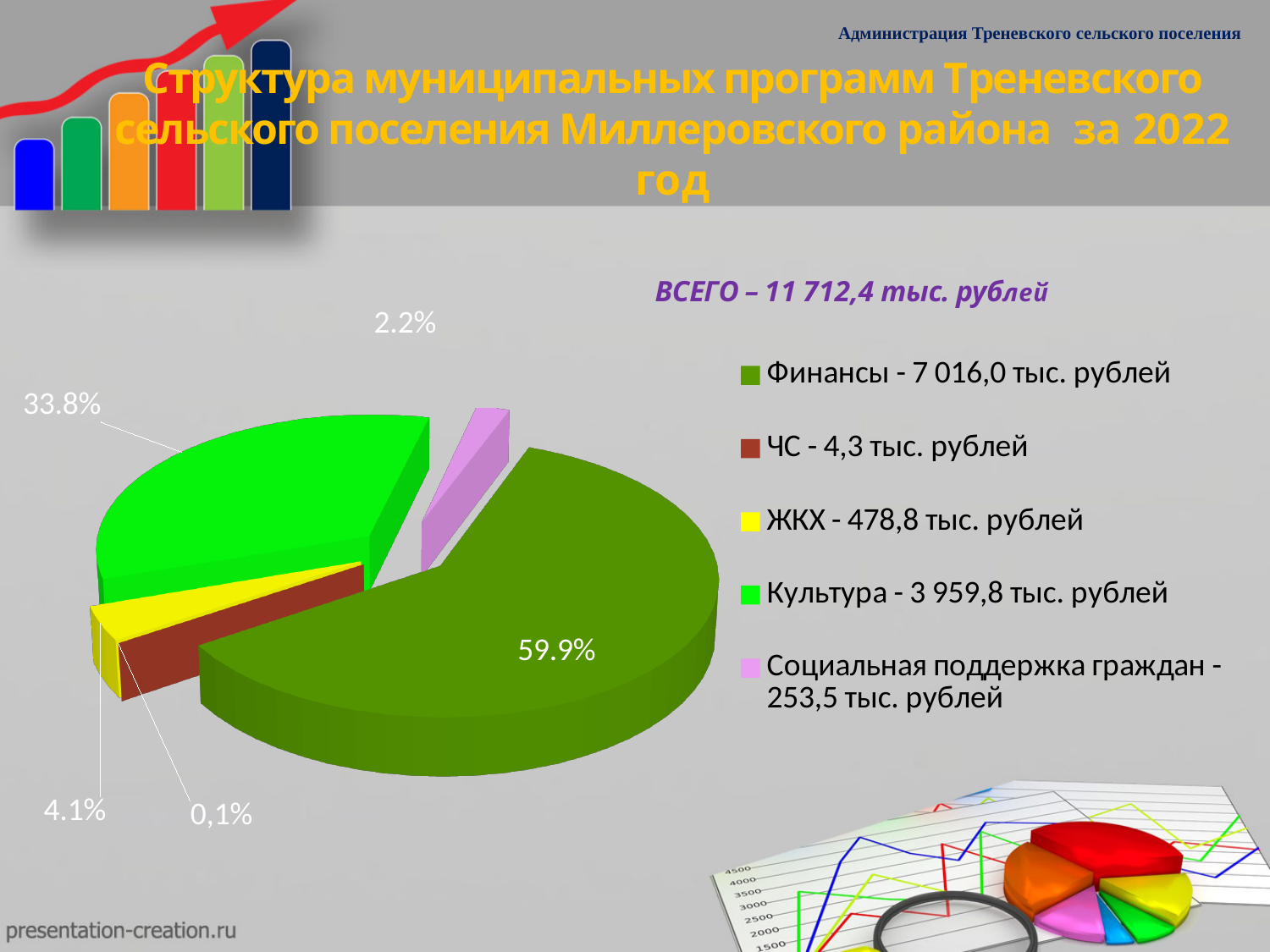
What total amount is stated above the legend? 11 712,4 тыс. рублей What kind of chart is shown on the slide? pie chart What share of the pie does Социальная поддержка граждан take? 2.2% What share of the pie does Финансы take? 59.9% According to the legend, what is the amount for Культура? 3 959,8 тыс. рублей How many slices does the pie chart have? 5 What share of the pie does ЧС take? 0,1% Which category has the smallest slice of the pie? ЧС Which category has the largest slice of the pie? Финансы How many entries does the legend list? 5